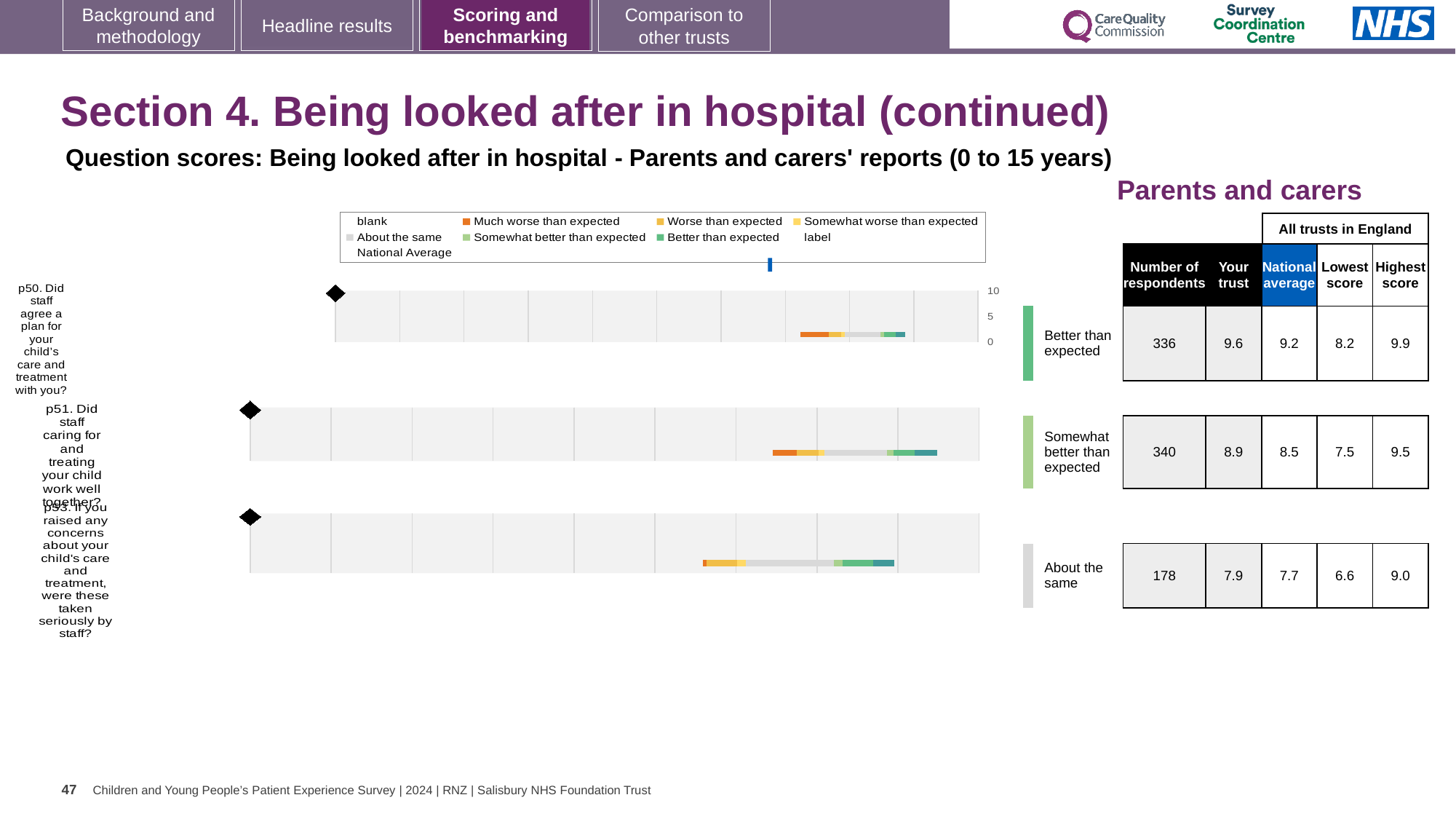
How many entries does the chart legend list? 9 For the p51 chart, what is the 'Your trust' score? 8.9 For the p53 chart, what is the national average score? 7.7 For p50, is the 'Your trust' score higher or lower than the national average? higher Which question (p50, p51 or p53) has the highest 'Your trust' score? p50 How many question charts (p50, p51, p53) are shown on the slide? 3 Which legend entry is shown in orange? Much worse than expected Which question (p50, p51 or p53) has the lowest number of respondents? p53 For p50, what is the difference between the highest score and the lowest score across all trusts in England? 1.7 For the p50 chart, how many respondents are listed in the table? 336 What kind of chart is used to show the p50 question score? bar chart What is the heading printed above the charts, starting with 'Question scores'? Question scores: Being looked after in hospital - Parents and carers' reports (0 to 15 years)